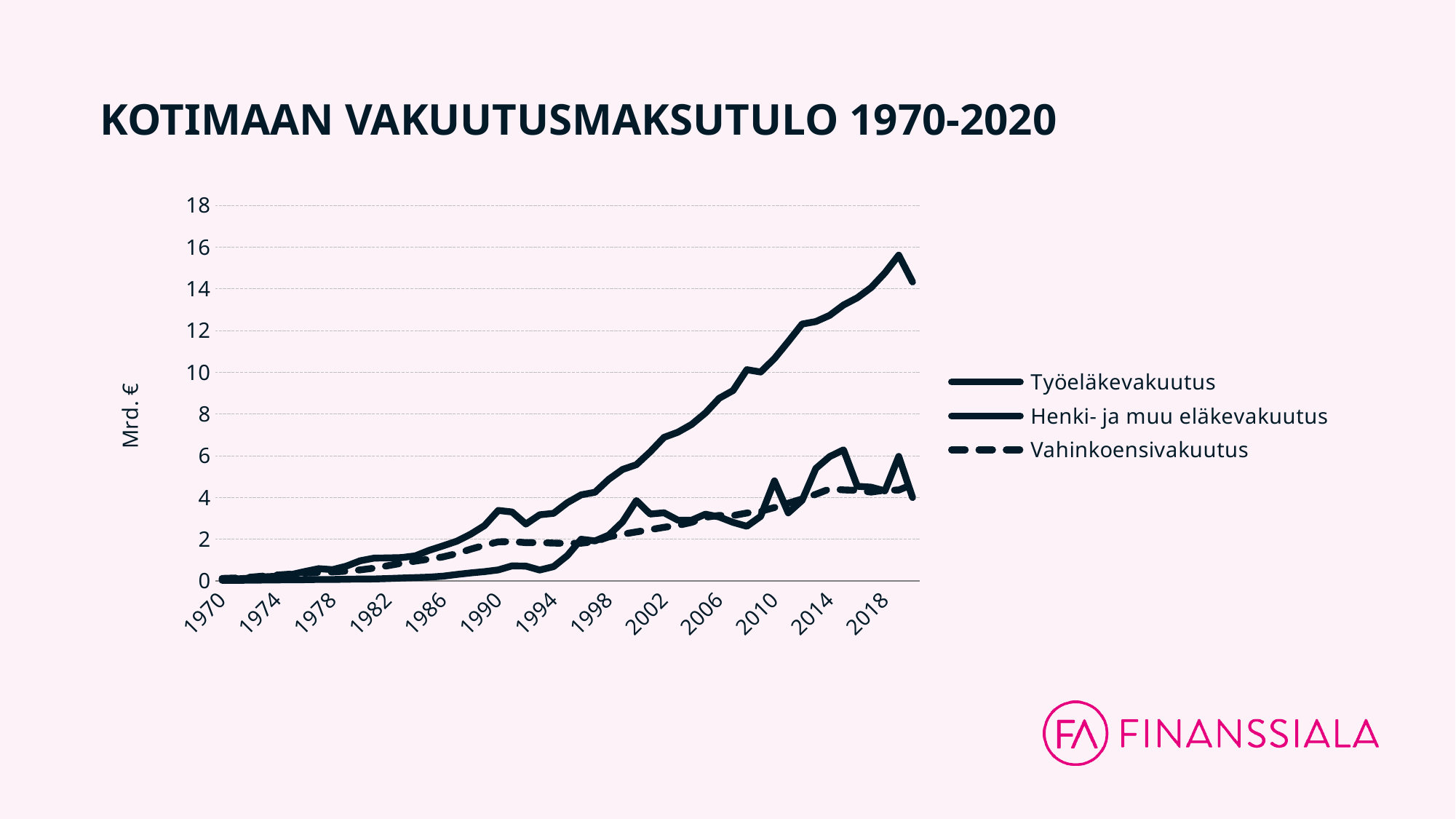
What is the title of the chart? KOTIMAAN VAKUUTUSMAKSUTULO 1970-2020 What is the label on the vertical axis? Mrd. € Which is larger in 2014, Työeläkevakuutus or Vahinkoensivakuutus? Työeläkevakuutus Does the Työeläkevakuutus series generally rise or fall from 1970 to 2020? rise Is the value for Työeläkevakuutus in 2010 greater or less than 8? greater Is the value for Työeläkevakuutus in 2002 greater or less than 4? greater Is the value for Vahinkoensivakuutus in 2018 greater or less than 6? less What kind of chart is shown on the slide? line chart Which series has the highest value in 2020? Työeläkevakuutus How many series does the legend list? 3 What is the highest value shown on the vertical axis? 18